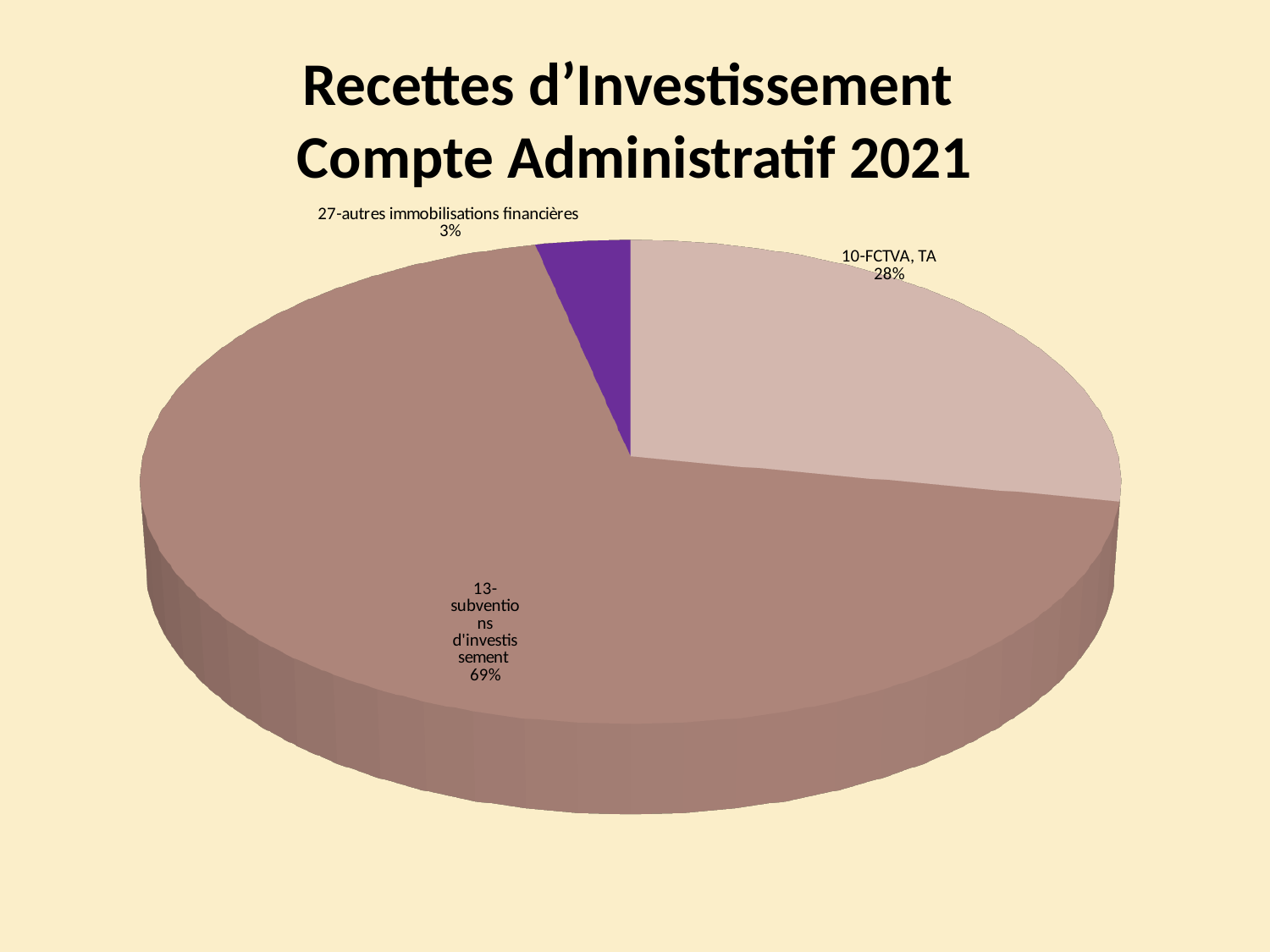
What is the difference in percentage points between 10-FCTVA, TA and 27-autres immobilisations financières? 25 What kind of chart is shown on the slide? pie chart What share of the pie does 13-subventions d'investissement represent? 69% Which category has the largest slice of the pie? 13-subventions d'investissement What colour is the slice for 27-autres immobilisations financières? purple What share of the pie does 10-FCTVA, TA represent? 28% What share of the pie does 27-autres immobilisations financières represent? 3% Which is larger, the share for 10-FCTVA, TA or the share for 27-autres immobilisations financières? 10-FCTVA, TA What is the difference in percentage points between 13-subventions d'investissement and 10-FCTVA, TA? 41 Which category has the smallest slice of the pie? 27-autres immobilisations financières How many categories are shown in the pie chart? 3 What is the title of the chart? Recettes d'Investissement Compte Administratif 2021